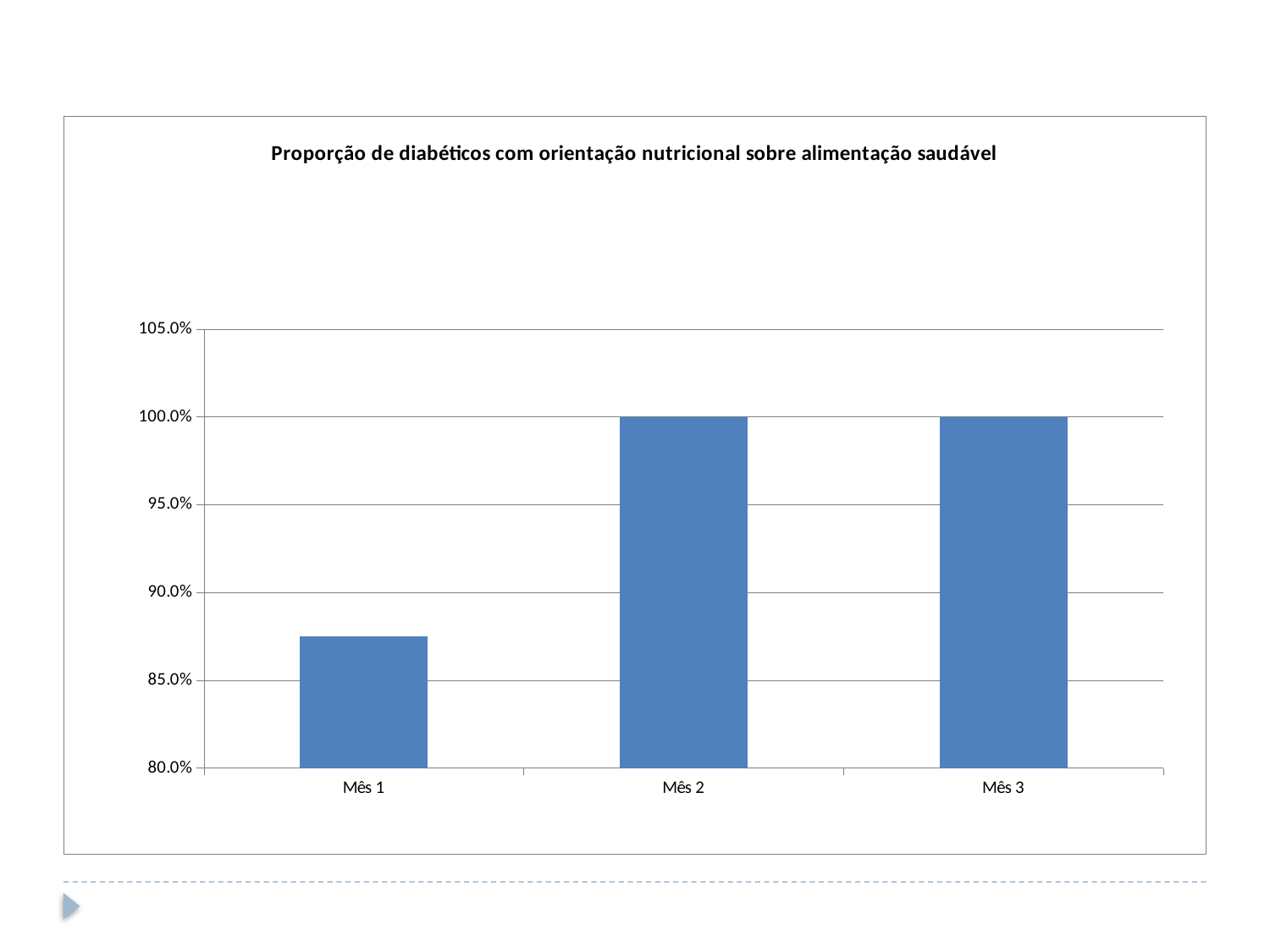
How many categories are plotted on the x axis? 3 What is the value for Mês 2? 100.0% Is the value for Mês 1 greater or less than 90.0%? less What type of chart is shown on the slide? bar chart Is the value for Mês 1 greater or less than 85.0%? greater What is the lowest value shown on the y axis? 80.0% Which is larger, the value for Mês 1 or the value for Mês 2? Mês 2 Which category has the lowest value? Mês 1 What is the value for Mês 3? 100.0% What is the title of the chart? Proporção de diabéticos com orientação nutricional sobre alimentação saudável Do the values rise or fall from Mês 1 to Mês 2? rise Are the values for Mês 2 and Mês 3 the same or different? the same